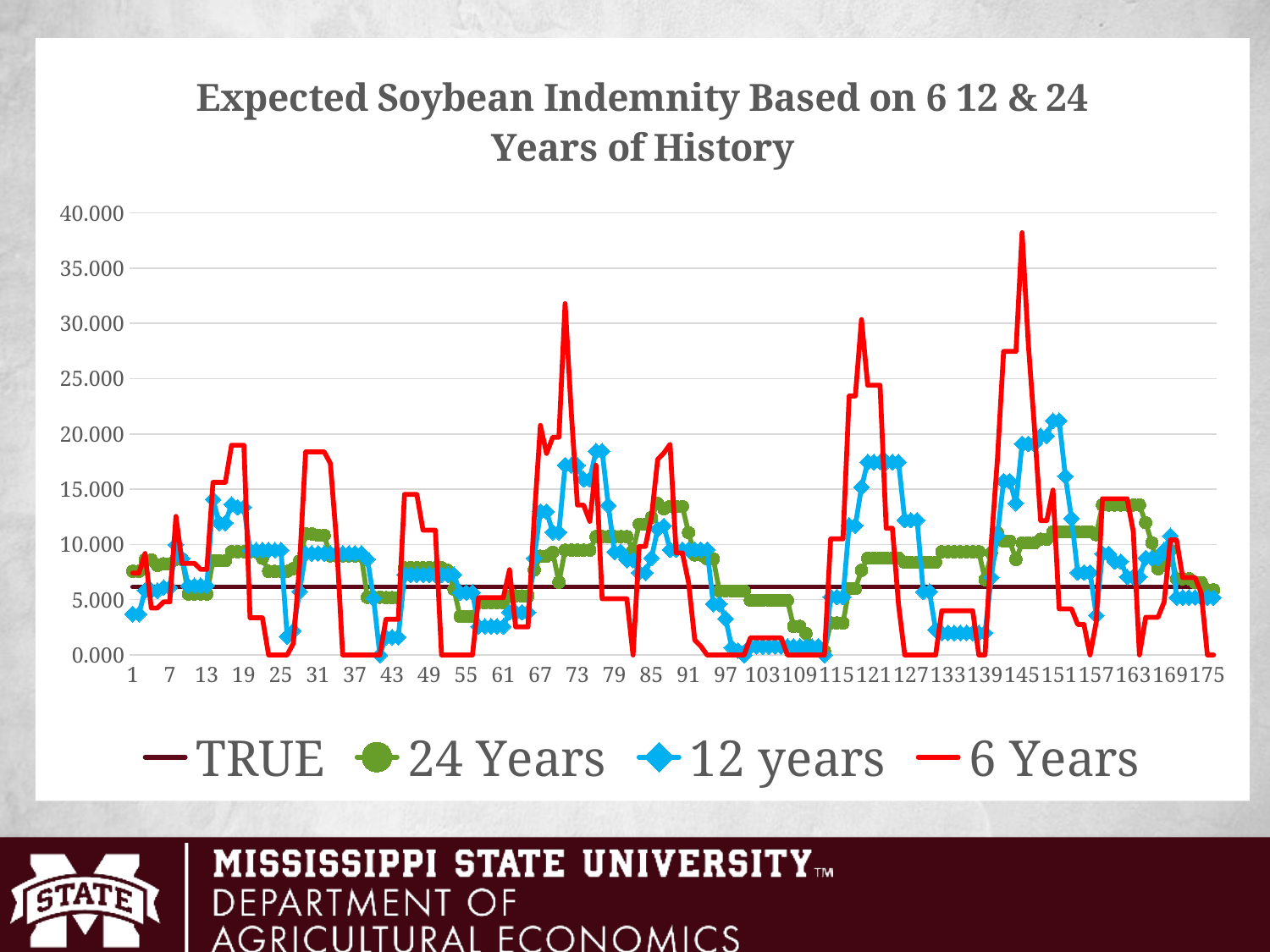
Is the highest value of the 24 Years series greater or less than 15.000? less Is the highest value of the 12 years series greater or less than 15.000? greater How many series does the legend list? 4 Is the highest value of the 6 Years series greater or less than 35.000? greater Which colour is used for the 6 Years series? red What is the title of the chart? Expected Soybean Indemnity Based on 6 12 & 24 Years of History Which series has the higher peak, 12 years or 24 Years? 12 years Which series has the higher peak, 6 Years or 12 years? 6 Years Which series reaches the highest value anywhere on the chart? 6 Years What kind of chart is shown on the slide? line chart How does the TRUE series change along the x axis? it stays flat